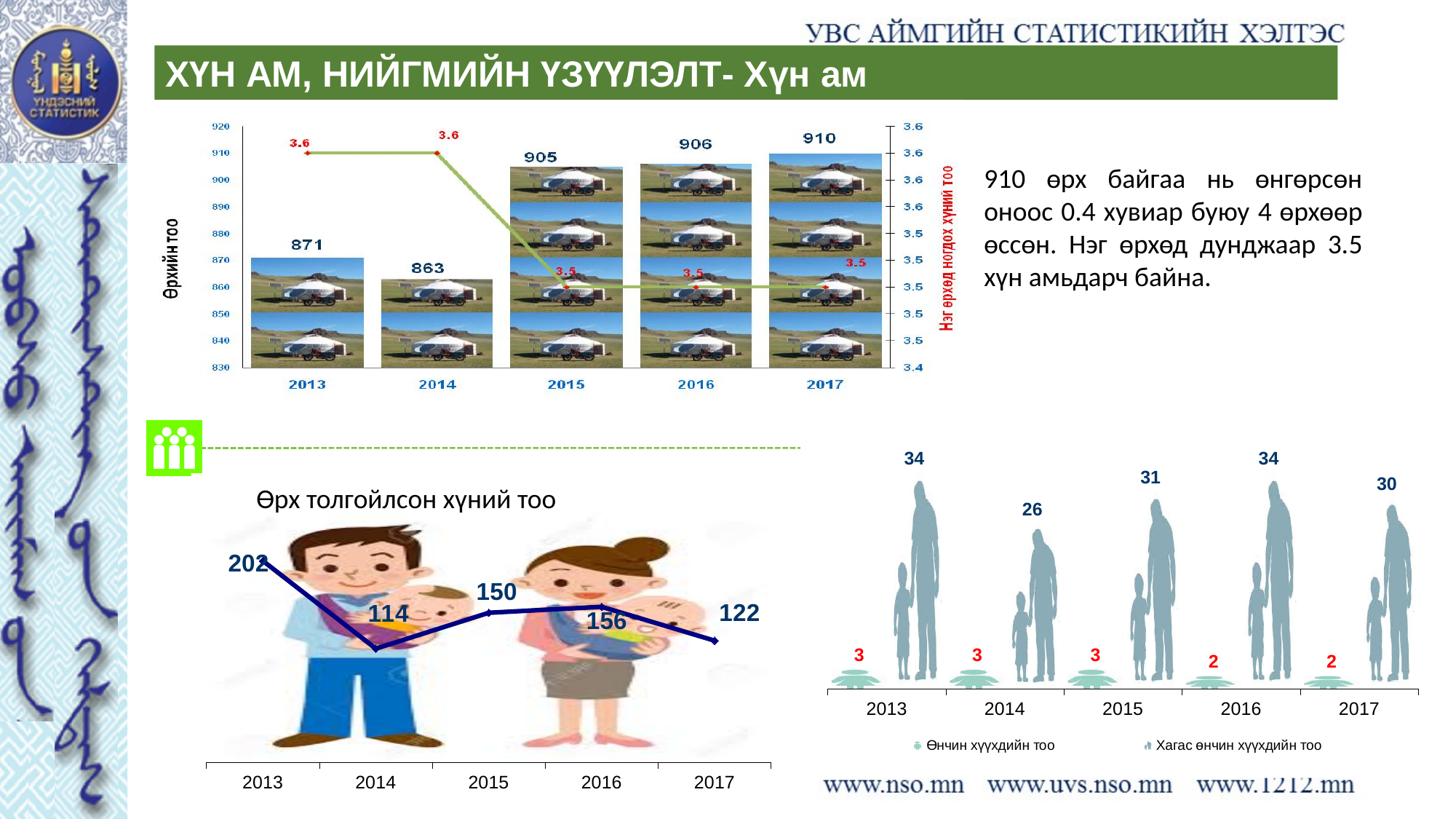
In the bottom-left chart 'Өрх толгойлсон хүний тоо', which year has the lowest value? 2014 In the top-left chart, how many years are shown on the x axis? 5 How many series does the legend of the bottom-right chart list? 2 In the bottom-right chart, what is the value for 'Өнчин хүүхдийн тоо' in 2016? 2 In the top-left chart of household counts, what is the difference between the 2017 and 2013 values? 39 In the top-left chart, what is the value of the red line (persons per household) for 2013? 3.6 In the bottom-left chart 'Өрх толгойлсон хүний тоо', what is the difference between the 2016 and 2015 values? 6 In the top-left chart of household counts, which year has the lowest number of households? 2014 In the bottom-right chart, what is the value for 'Хагас өнчин хүүхдийн тоо' in 2014? 26 In the bottom-left chart 'Өрх толгойлсон хүний тоо', what is the value for 2013? 202 What kind of chart is the bottom-left chart 'Өрх толгойлсон хүний тоо'? line chart In the top-left chart of household counts, what is the value for 2017? 910